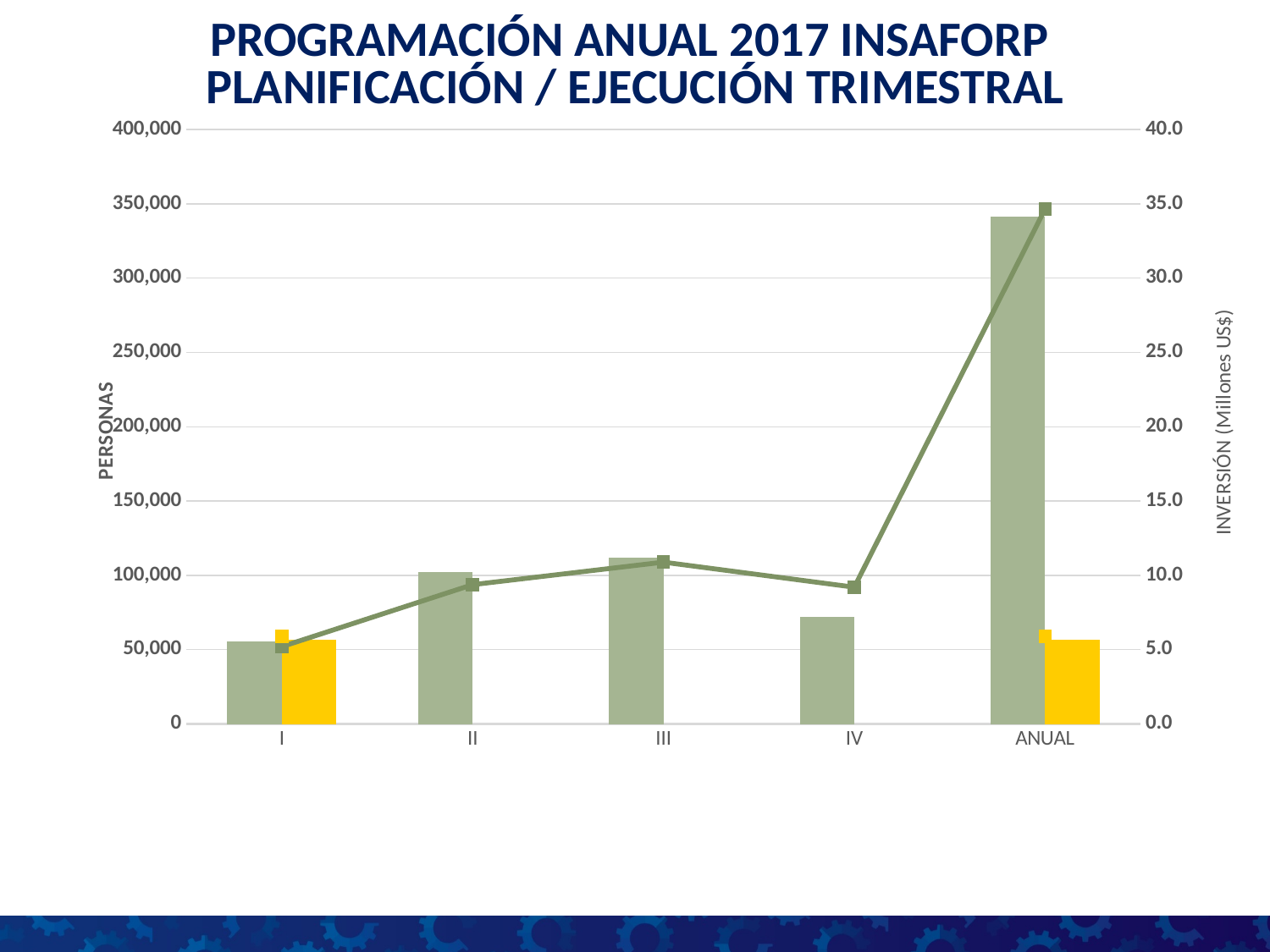
How many categories are shown on the x axis? 5 Does the line rise or fall from category I to category III? rises What is the title of the right-hand vertical axis? INVERSIÓN (Millones US$) Is the green bar for III greater or less than 100,000 on the PERSONAS axis? greater At which category does the line reach its highest point? ANUAL Is the green bar for IV greater or less than 100,000 on the PERSONAS axis? less What kind of chart is shown on the slide? A bar chart combined with a line Is the green bar for ANUAL greater or less than 300,000 on the PERSONAS axis? greater Which category has the shortest green bar? I Which category has the tallest green bar? ANUAL Which green bar is taller, III or IV? III